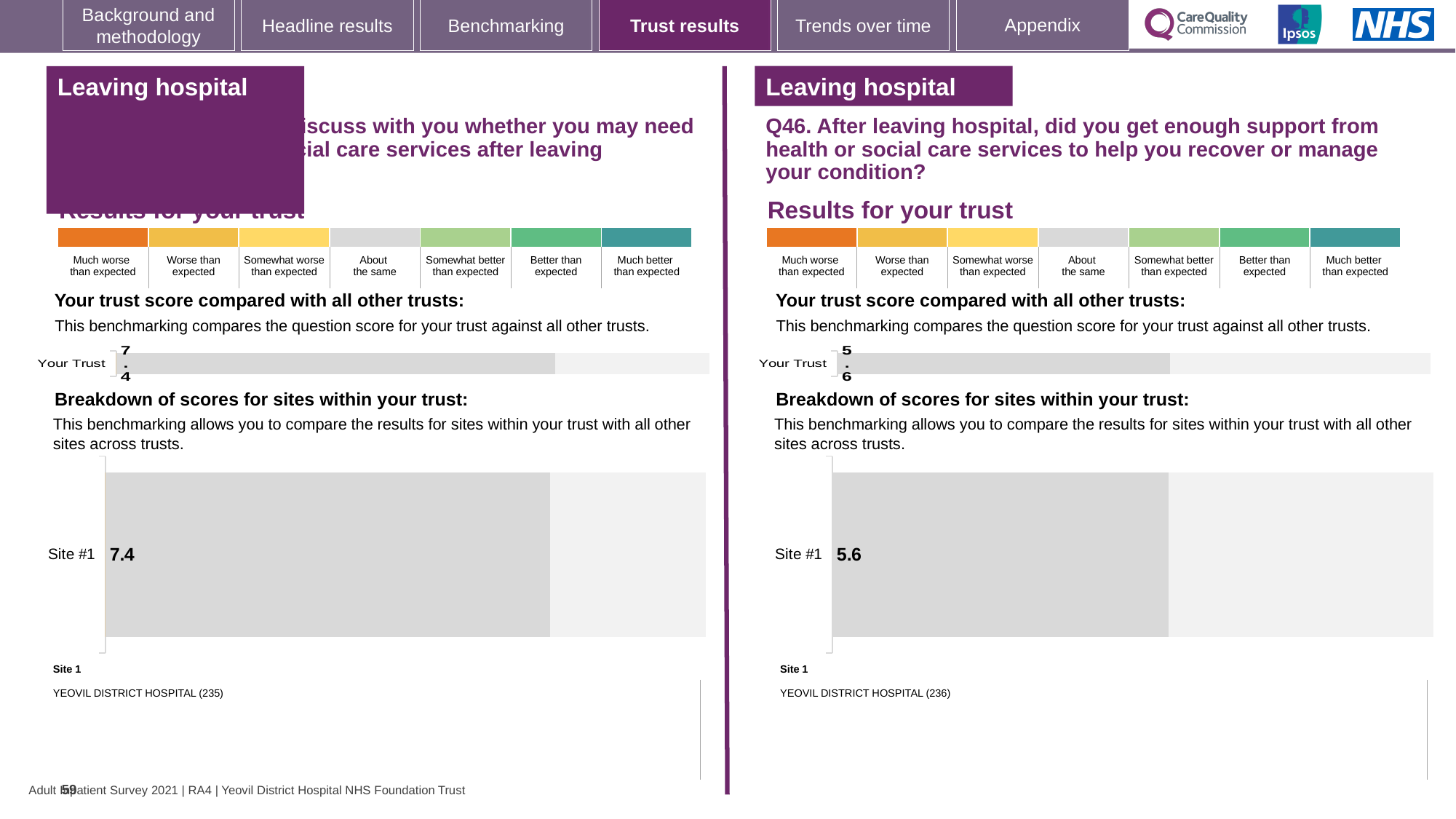
Is the Site #1 score on the right-hand side of the slide (Q46) greater or less than the Site #1 score on the left-hand side? less Which is larger: the Your Trust score on the left-hand side of the slide or the Your Trust score on the right-hand side (Q46)? Left-hand side (7.4) How many sites are shown in the breakdown of scores chart on the left-hand side of the slide? 1 On the right-hand side of the slide (Q46), what score is shown for Site #1 in the breakdown of scores for sites within your trust? 5.6 On the left-hand side of the slide, what score is shown for Site #1 in the breakdown of scores for sites within your trust? 7.4 On the left-hand side of the slide, what is the score shown for Your Trust? 7.4 On the right-hand side of the slide (Q46), what is the score shown for Your Trust? 5.6 What is the difference between the Site #1 score on the left-hand side of the slide and the Site #1 score on the right-hand side (Q46)? 1.8 What type of chart is used to show the Site #1 score on the right-hand side of the slide (Q46)? Bar chart How many sites are shown in the breakdown of scores chart on the right-hand side of the slide (Q46)? 1 Which site is listed as Site 1 on the right-hand side of the slide (Q46)? YEOVIL DISTRICT HOSPITAL (236) Which site is listed as Site 1 on the left-hand side of the slide? YEOVIL DISTRICT HOSPITAL (235)